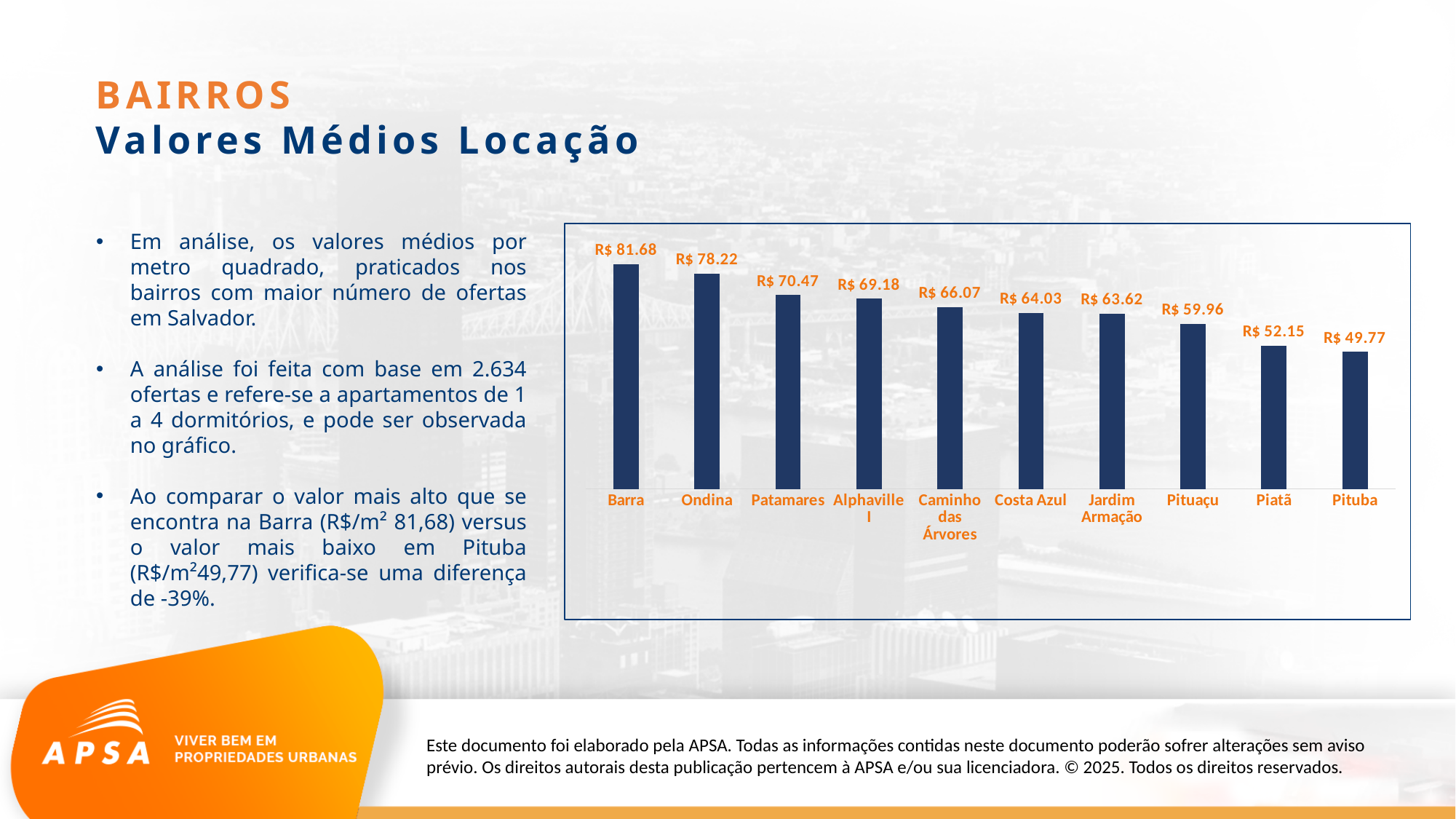
Which neighbourhood has the highest value in the chart? Barra How many neighbourhoods are shown in the chart? 10 Which neighbourhood has the lowest value in the chart? Pituba What is the value shown for Pituaçu? R$ 59.96 What is the difference between the values for Ondina and Patamares? R$ 7.75 What is the value shown for Piatã? R$ 52.15 What is the value shown for Caminho das Árvores? R$ 66.07 What is the value shown for Barra? R$ 81.68 Do the values rise or fall from left to right across the chart? Fall What is the difference between the values for Barra and Pituba? R$ 31.91 Which has a larger value, Alphaville I or Costa Azul? Alphaville I What kind of chart is shown on the slide? Bar chart